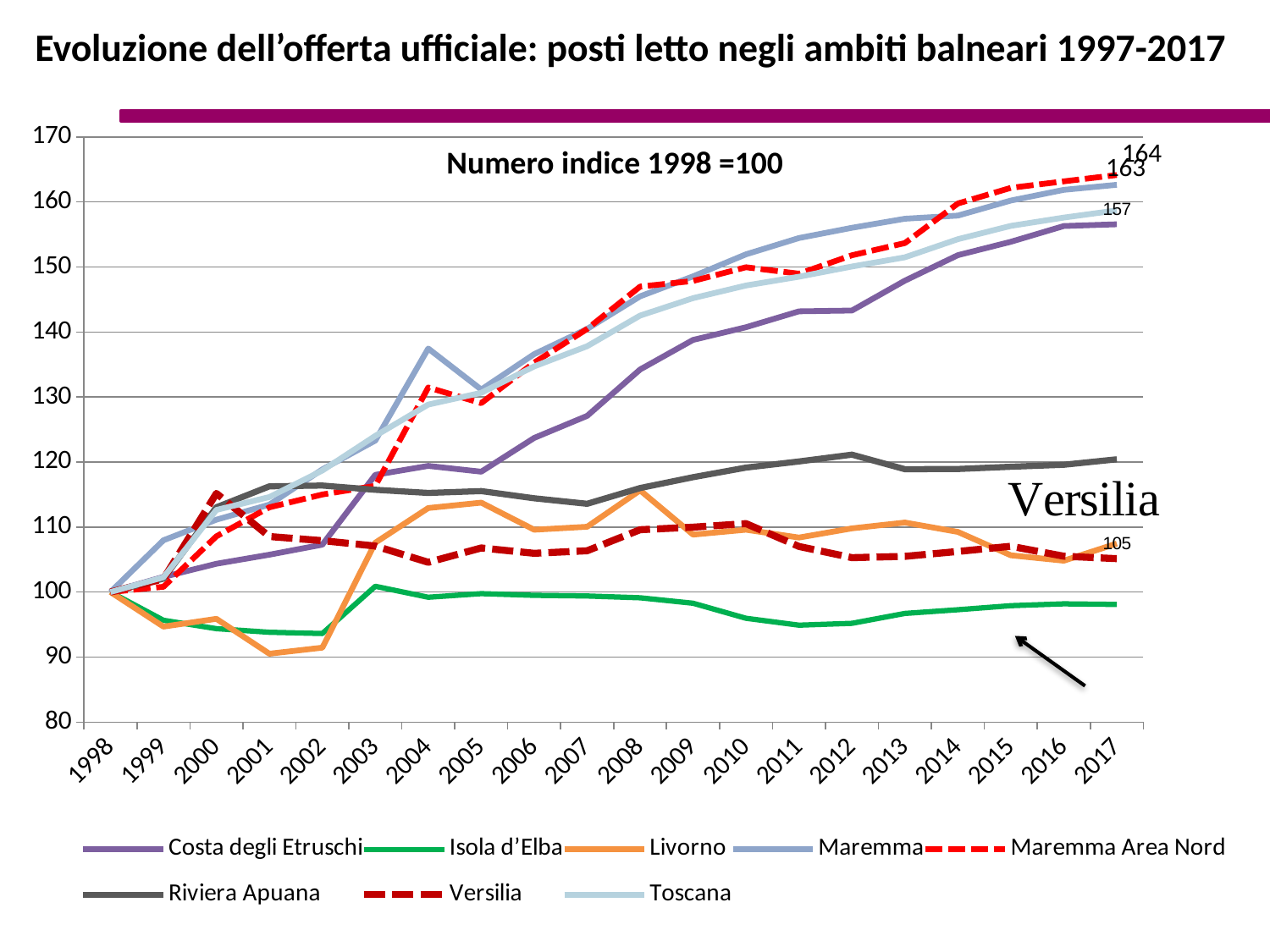
Which series has the highest value in 2017? Maremma Area Nord Which series has the lowest value in 2017? Isola d'Elba What is the difference between the 2017 values of Maremma Area Nord and Maremma? 1 How many years are shown along the x axis? 20 What base year and value does the index use, according to the text inside the chart? 1998 = 100 Is the value for Costa degli Etruschi in 2017 greater or less than 150? greater Does the Maremma series rise or fall from 1998 to 2017? rise Is the value for Isola d'Elba in 2017 greater or less than 100? less What is the value for Maremma in 2017? 163 How many series does the legend list? 8 What is the value for Maremma Area Nord in 2017? 164 What kind of chart is shown on the slide? line chart